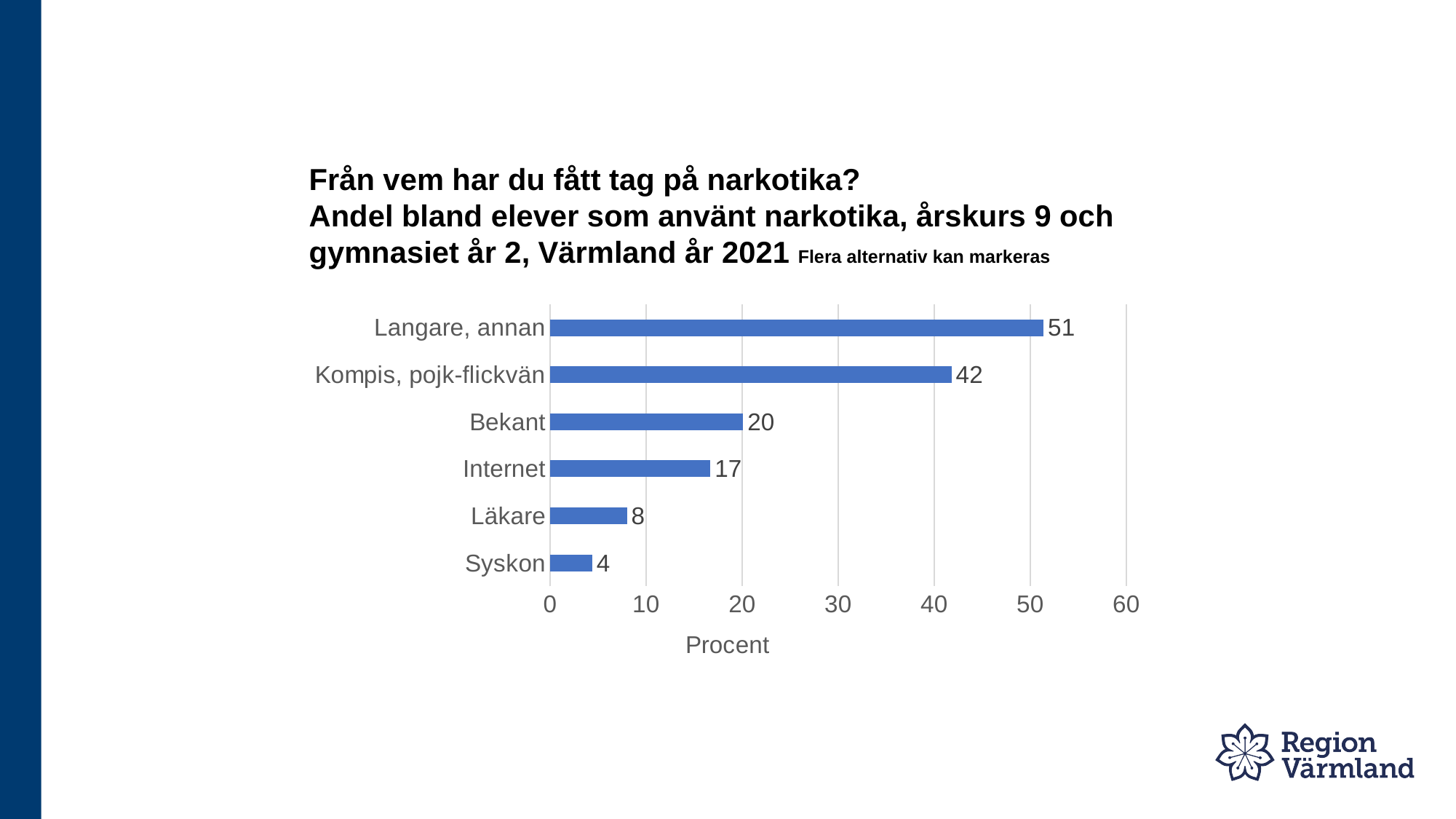
Which has a larger value, "Bekant" or "Läkare"? Bekant Which category has the lowest value? Syskon What kind of chart is shown on the slide? bar chart Is the value for "Kompis, pojk-flickvän" greater or less than 40? greater Which category has the highest value? Langare, annan What is the label of the horizontal axis? Procent What is the value for "Läkare"? 8 What is the difference between the values for "Bekant" and "Internet"? 3 How many categories are shown in the chart? 6 What is the value for "Langare, annan"? 51 What is the value for "Internet"? 17 What is the difference between the values for "Langare, annan" and "Kompis, pojk-flickvän"? 9